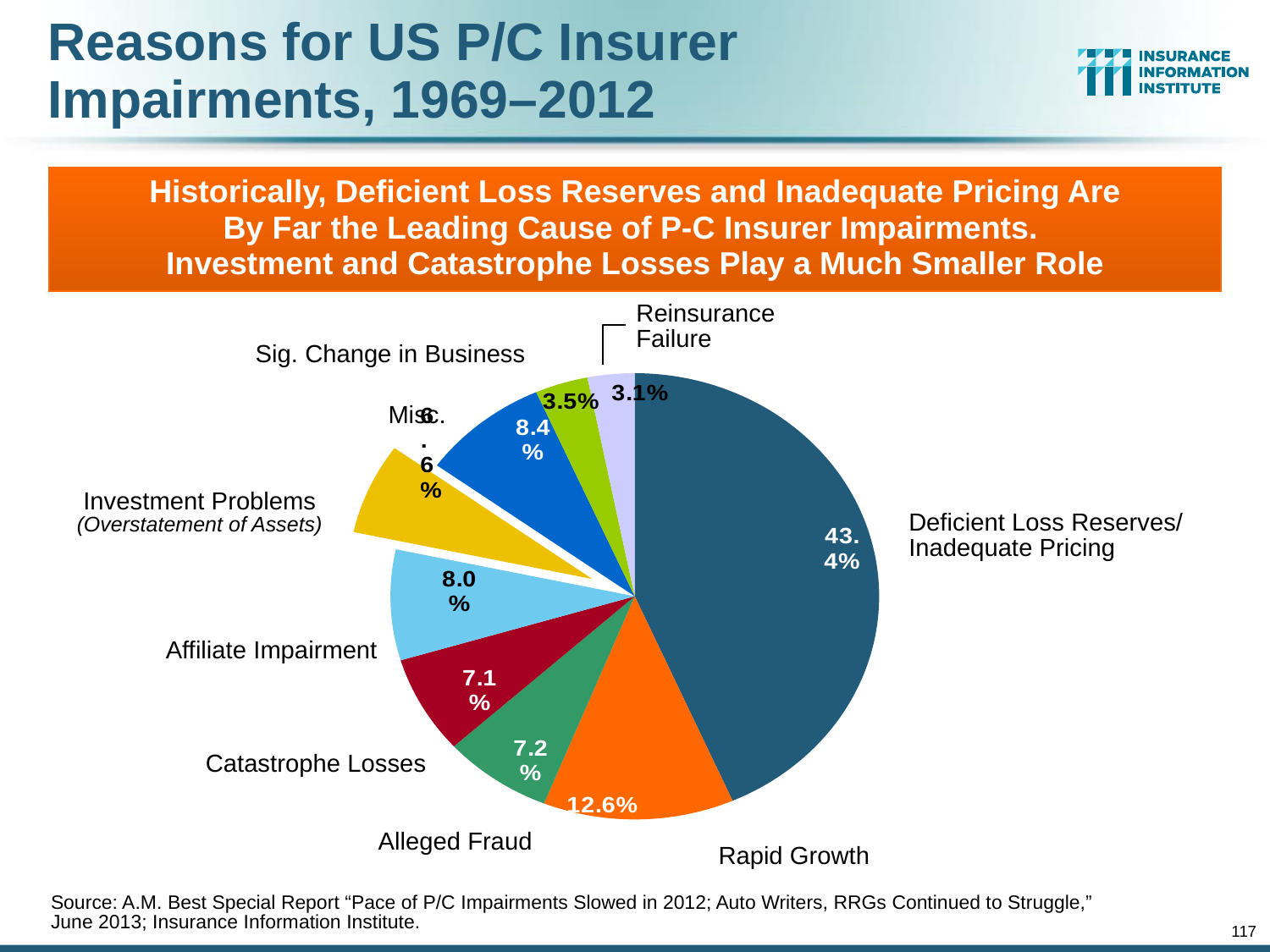
How many slices does the pie chart have? 9 How many percentage points larger is the Deficient Loss Reserves/Inadequate Pricing share than the Rapid Growth share? 30.8 percentage points What percentage of impairments is attributed to Rapid Growth? 12.6% What percentage of impairments is attributed to Catastrophe Losses? 7.1% What kind of chart is shown on the slide? pie chart What is the title of the slide containing the pie chart? Reasons for US P/C Insurer Impairments, 1969–2012 Which reason accounts for the smallest share of impairments? Reinsurance Failure Which reason accounts for the largest share of impairments? Deficient Loss Reserves/Inadequate Pricing What percentage of impairments is attributed to Affiliate Impairment? 8.0% What share of US P/C insurer impairments is attributed to Deficient Loss Reserves/Inadequate Pricing? 43.4% Which has a larger share, Affiliate Impairment or Catastrophe Losses? Affiliate Impairment What percentage of impairments is attributed to Reinsurance Failure? 3.1%